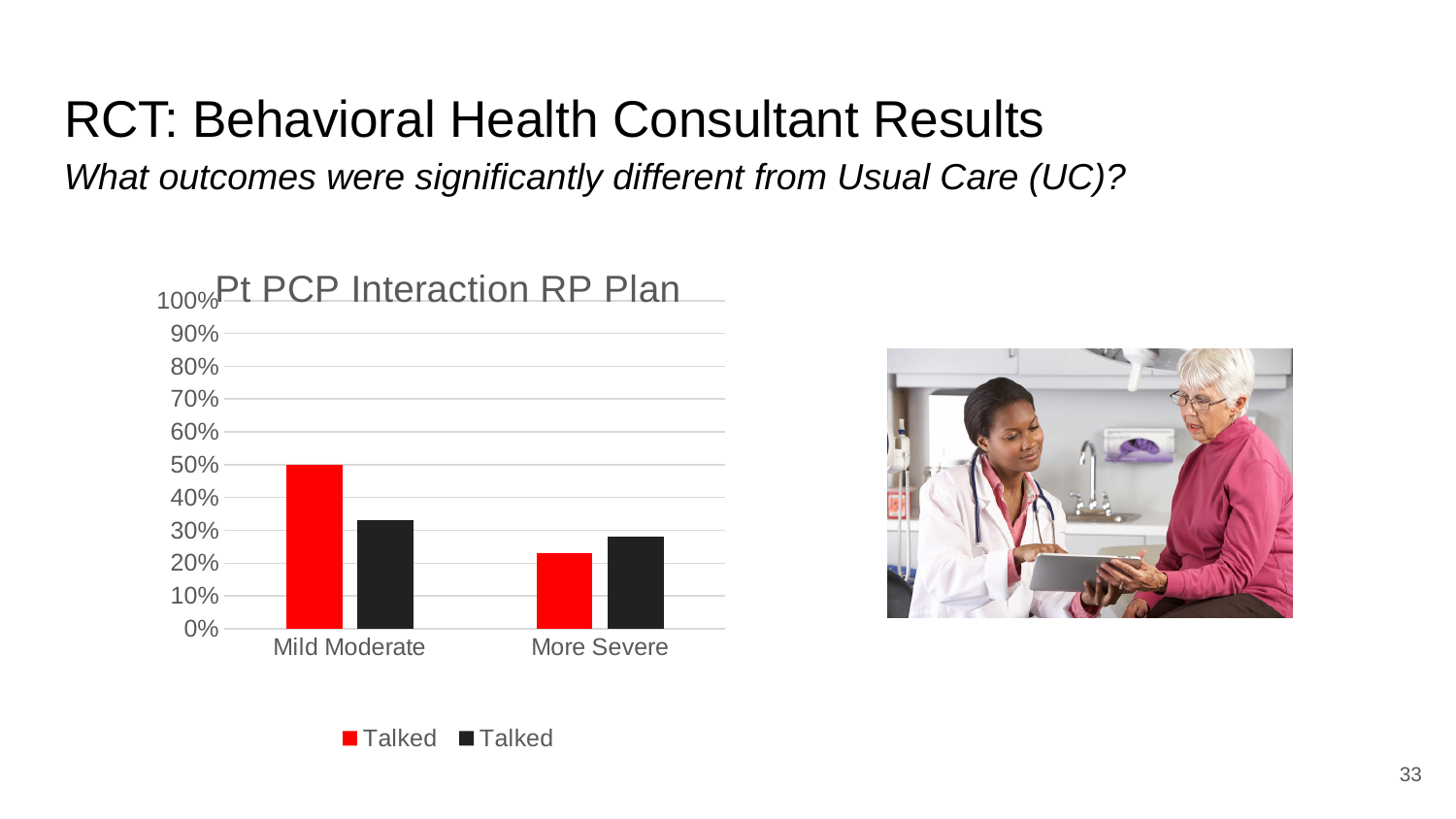
For Mild Moderate, which bar is taller, the red bar or the black bar? the red bar What is the title of the chart? Pt PCP Interaction RP Plan How many categories are shown on the x axis of the chart? 2 Is the value of the black bar for Mild Moderate greater or less than 40%? less Which bar in the chart is the tallest? the red bar for Mild Moderate Is the value of the red bar for More Severe greater or less than 20%? greater Which bar in the chart is the shortest? the red bar for More Severe What kind of chart is shown on the slide? bar chart For More Severe, which bar is taller, the red bar or the black bar? the black bar What is the value of the red bar for Mild Moderate? 50% Is the value of the black bar for More Severe greater or less than 30%? less How many series does the chart's legend list? 2